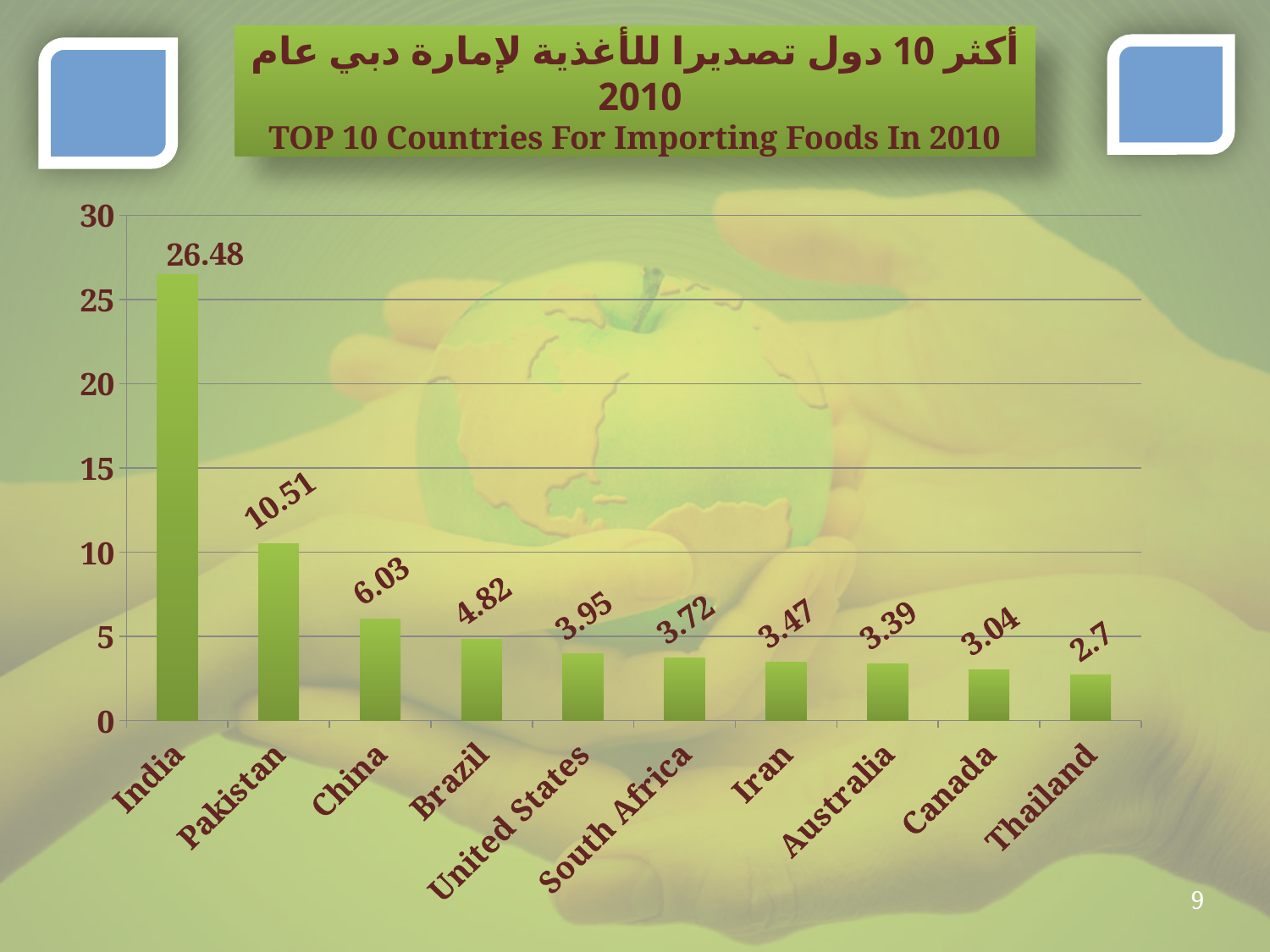
What is the difference between the values for China and Brazil? 1.21 Is the value for Pakistan greater or less than 10? greater Which is larger, the value for Iran or the value for Canada? Iran Which country has the highest value? India What is the value for India? 26.48 What is the value for South Africa? 3.72 What is the difference between the values for India and Pakistan? 15.97 What is the value for Pakistan? 10.51 Which country has the lowest value? Thailand What kind of chart is shown on the slide? Bar chart How many countries are shown in the chart? 10 What is the value for Thailand? 2.7